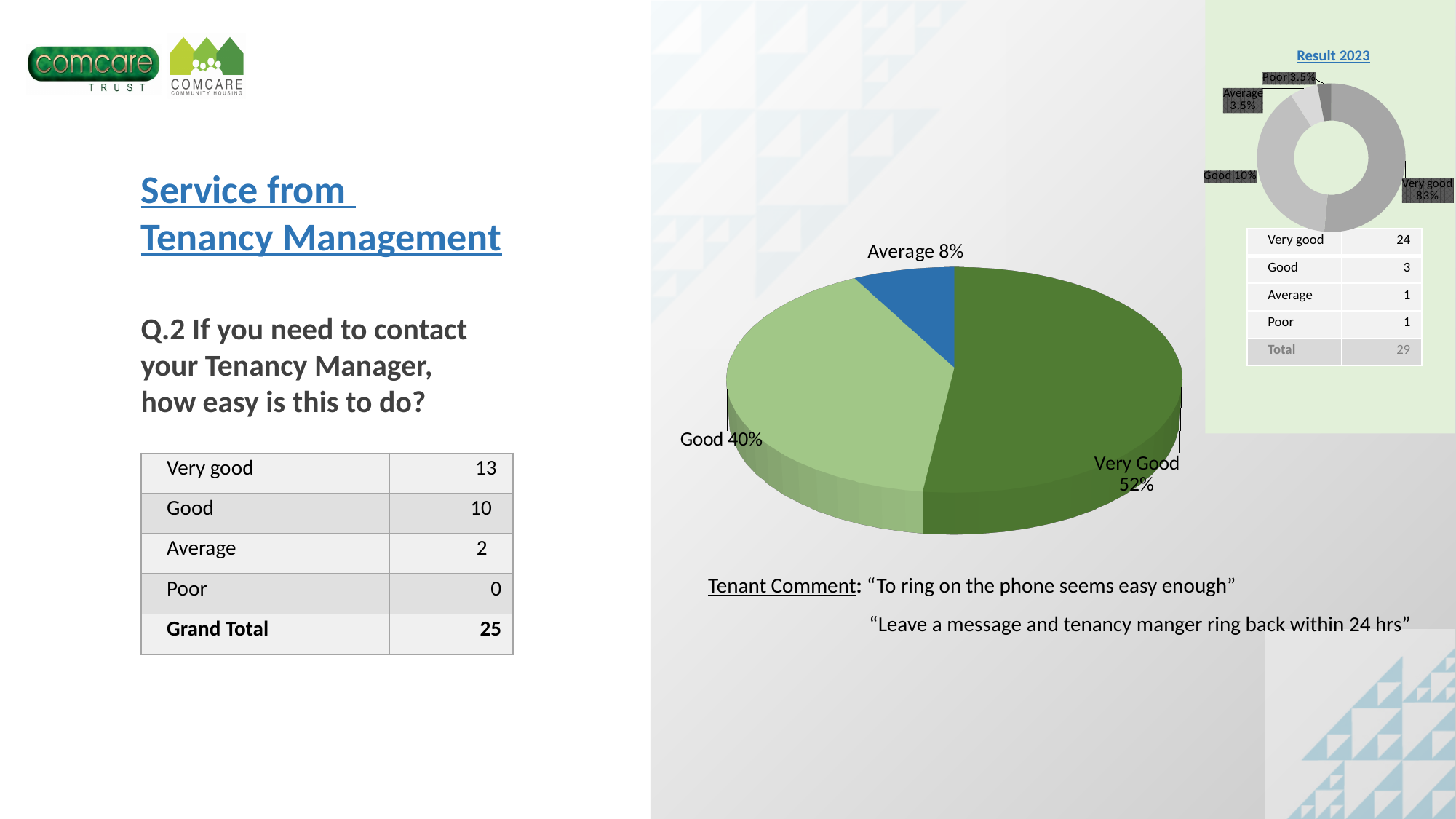
In the large pie chart, which category has the largest slice? Very Good In the Result 2023 donut chart, how many categories are labelled? 4 In the Result 2023 donut chart, what share is labelled for Very good? 83% In the large pie chart, which category has the smallest slice? Average In the Result 2023 donut chart, what share is labelled for Poor? 3.5% In the large pie chart, how many slices are shown? 3 In the Result 2023 donut chart, what share is labelled for Good? 10% In the large pie chart, how many percentage points larger is the Very Good slice than the Good slice? 12 In the large pie chart, what share is labelled for Average? 8% In the large pie chart, what share is labelled for Very Good? 52% In the large pie chart, what share is labelled for Good? 40% What kind of chart is the large chart in the centre of the slide? Pie chart